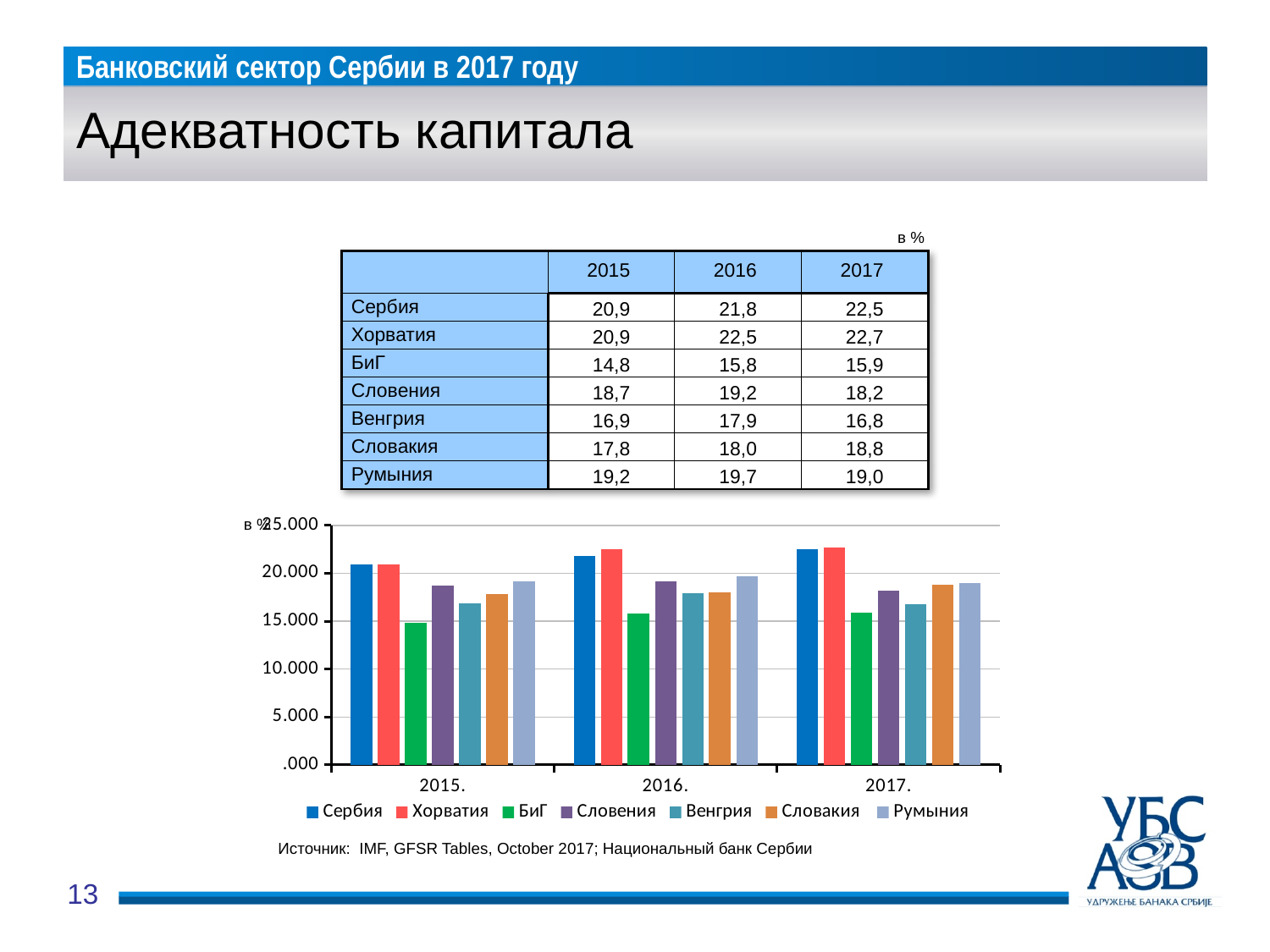
What is the value for БиГ in 2015? 14,8 What kind of chart is shown on the slide? bar chart Do the values for Сербия rise or fall from 2015 to 2017? rise Which country has the highest value in 2016? Хорватия Is the value for Хорватия in 2016 greater or less than 20.000? greater What is the capital adequacy value for Сербия in 2017? 22,5 How many year groups are shown on the x axis of the chart? 3 Which country has the lowest value in 2016? БиГ Which is larger in 2017, the value for Словакия or the value for Венгрия? Словакия How many series does the chart legend list? 7 What is the difference between the values for Сербия and БиГ in 2017? 6,6 Is the value for Словения in 2015 greater or less than 20.000? less